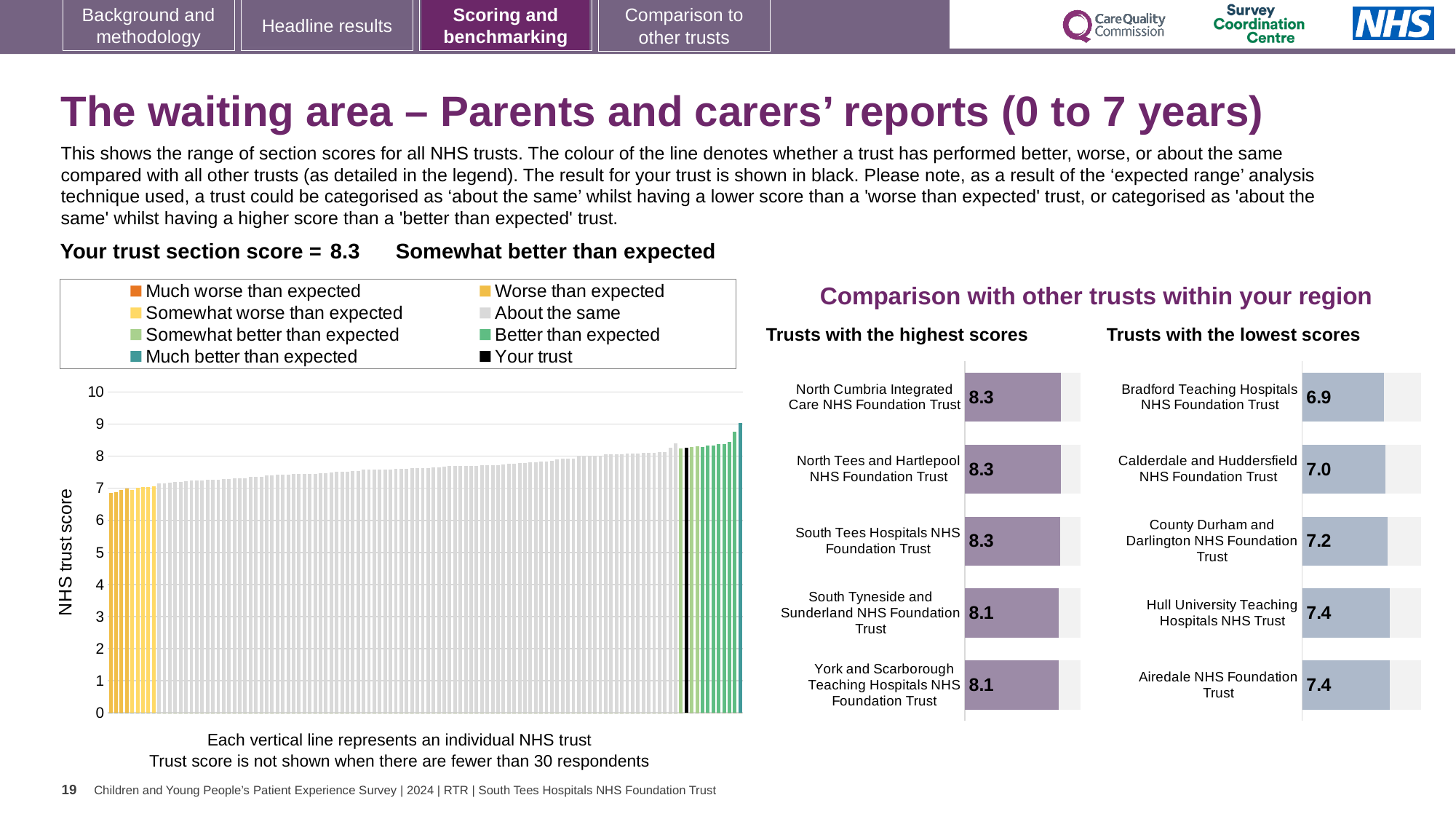
In the 'Trusts with the highest scores' chart, what is the score for South Tyneside and Sunderland NHS Foundation Trust? 8.1 In the 'Trusts with the highest scores' chart, what is the difference between the scores of North Cumbria Integrated Care NHS Foundation Trust and York and Scarborough Teaching Hospitals NHS Foundation Trust? 0.2 What is your trust's section score shown on the slide? 8.3 In the large chart on the left, what is the label on the vertical axis? NHS trust score In the 'Trusts with the lowest scores' chart, which has the higher score: Calderdale and Huddersfield NHS Foundation Trust or Hull University Teaching Hospitals NHS Trust? Hull University Teaching Hospitals NHS Trust In the 'Trusts with the lowest scores' chart, what is the score for County Durham and Darlington NHS Foundation Trust? 7.2 In the large chart on the left, is the tallest bar greater or less than 8? greater How many trusts are shown in the 'Trusts with the highest scores' chart? 5 In the large chart on the left, do the bar heights rise or fall from left to right? Rise How many entries does the legend above the large chart on the left list? 8 What kind of chart is the large chart on the left showing NHS trust scores? Bar chart In the 'Trusts with the lowest scores' chart, which trust has the lowest score? Bradford Teaching Hospitals NHS Foundation Trust